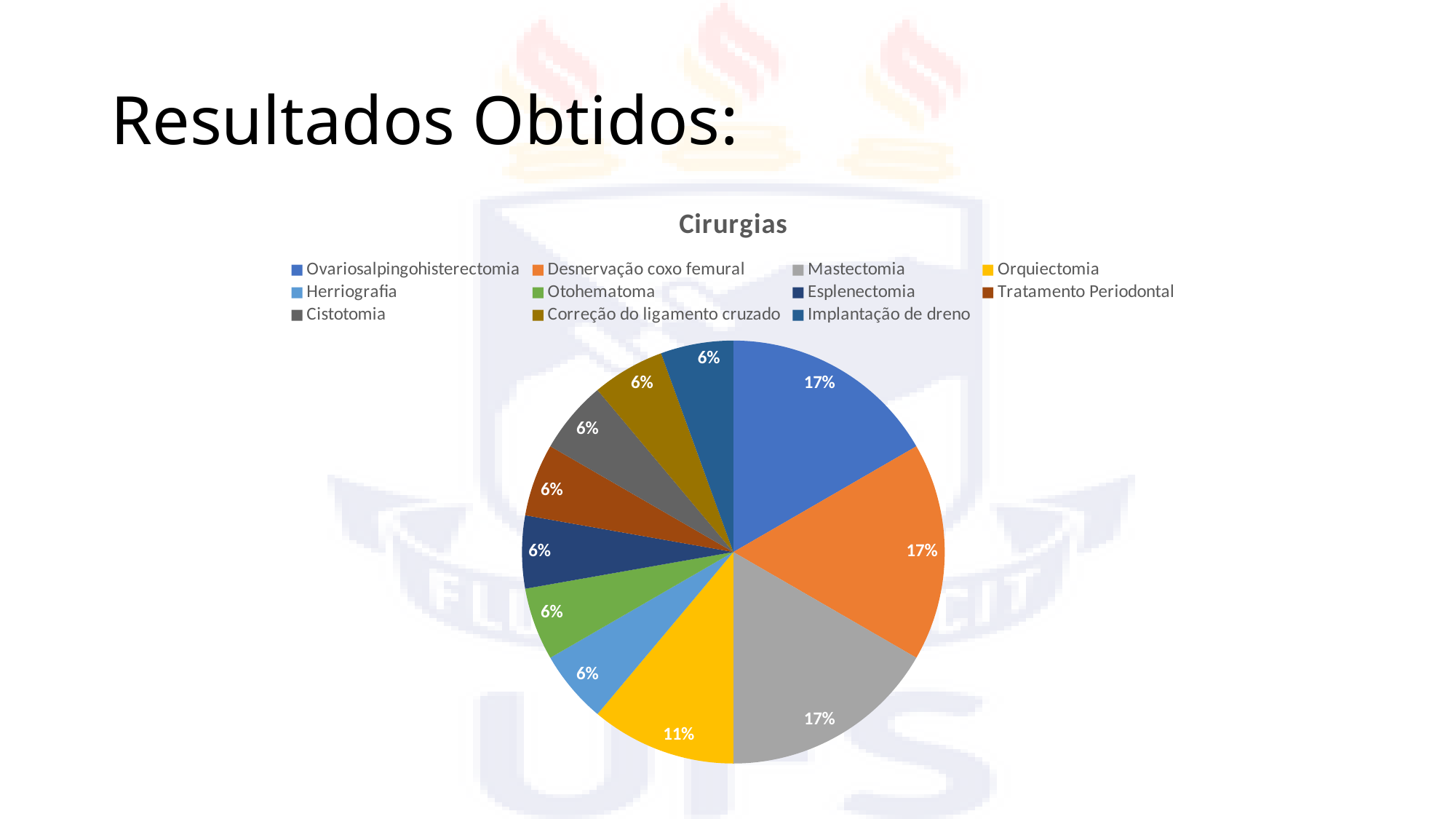
What is the smallest percentage shown on any slice of the pie chart? 6% What share of the pie does Herriografia represent? 6% What is the title of the chart? Cirurgias Which has a larger share, Orquiectomia or Otohematoma? Orquiectomia What colour is the Orquiectomia slice in the pie chart? yellow What share of the pie does Orquiectomia represent? 11% How many categories (slices) does the pie chart have? 11 What is the largest percentage shown on any slice of the pie chart? 17% What share of the pie does Mastectomia represent? 17% What type of chart is shown on the slide? pie chart What is the difference in percentage points between the Ovariosalpingohisterectomia slice and the Orquiectomia slice? 6 percentage points